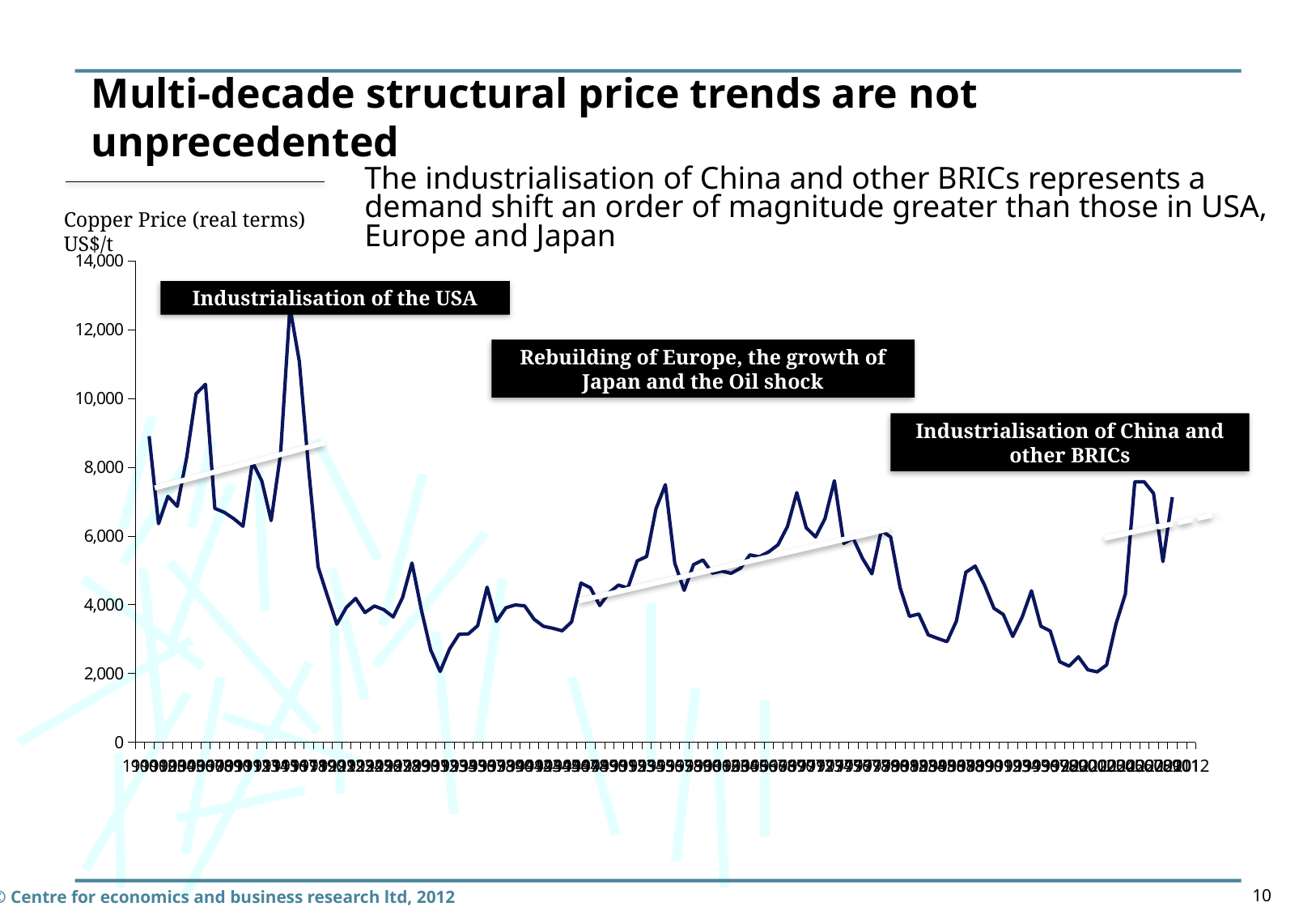
Is the copper price at the end of the series in 2012 greater or less than 6,000? greater What kind of chart is shown on the slide? line chart What is the first year shown on the x axis? 1900 Is the copper price at the start of the series in 1900 greater or less than 8,000? greater What unit is the copper price plotted in? US$/t Is the lowest point of the copper price line greater or less than 4,000? less Does the white trend line under the 'Industrialisation of the USA' label slope upward or downward? upward What is the last year shown on the x axis? 2012 What is the title of the chart on the slide? Copper Price (real terms) US$/t How many black annotation boxes label periods on the chart? 3 What is the highest value shown on the y axis? 14,000